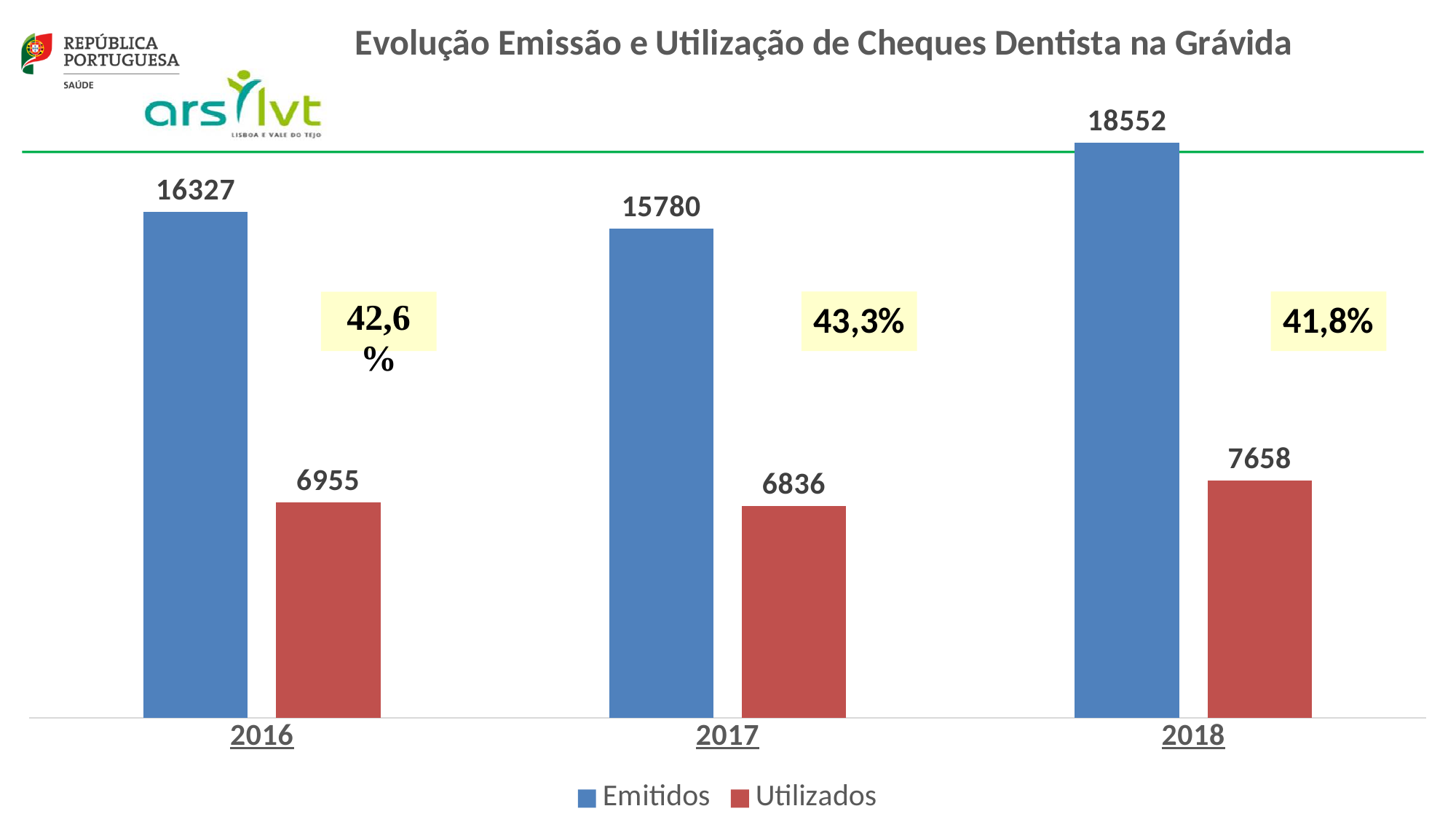
What percentage is shown in the label for 2017? 43,3% What kind of chart is shown on the slide? Bar chart What is the difference between Emitidos and Utilizados in 2018? 10894 Which is larger, Emitidos in 2016 or Emitidos in 2017? Emitidos in 2016 What is the value of Emitidos in 2016? 16327 How many series does the legend list? 2 In which year is the Emitidos value highest? 2018 What is the value of Utilizados in 2018? 7658 How many years are shown on the x axis? 3 What is the difference between Emitidos in 2018 and Emitidos in 2017? 2772 What is the value of Utilizados in 2017? 6836 In which year is the Utilizados value lowest? 2017